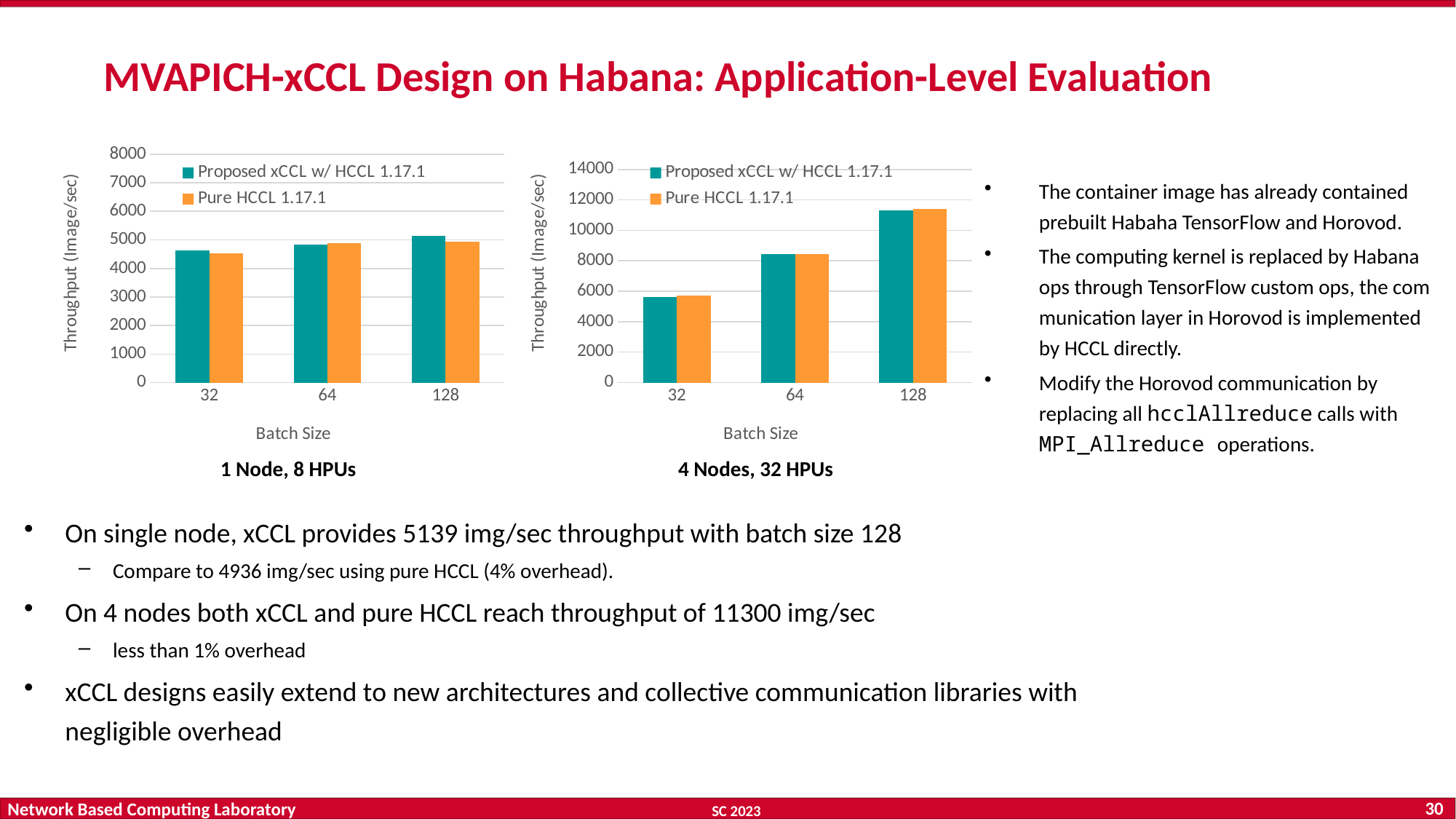
In the "4 Nodes, 32 HPUs" chart, is the Proposed xCCL w/ HCCL 1.17.1 value at batch size 128 greater or less than 10000? greater In the "4 Nodes, 32 HPUs" chart, which is larger for Proposed xCCL w/ HCCL 1.17.1: batch size 64 or batch size 128? 128 How many series does the legend of the "4 Nodes, 32 HPUs" chart list? 2 In the "1 Node, 8 HPUs" chart, is the Pure HCCL 1.17.1 value at batch size 32 greater or less than 4000? greater In the "4 Nodes, 32 HPUs" chart, is the Pure HCCL 1.17.1 value at batch size 32 greater or less than 6000? less How many batch sizes are shown on the x axis of the "1 Node, 8 HPUs" chart? 3 In the "4 Nodes, 32 HPUs" chart, does throughput rise or fall as batch size increases? rise In the "1 Node, 8 HPUs" chart, which batch size has the highest throughput for Proposed xCCL w/ HCCL 1.17.1? 128 What is the y-axis label of the "1 Node, 8 HPUs" chart? Throughput (Image/sec) What kind of chart is the "1 Node, 8 HPUs" chart? bar chart In the "4 Nodes, 32 HPUs" chart, which batch size has the lowest throughput for Pure HCCL 1.17.1? 32